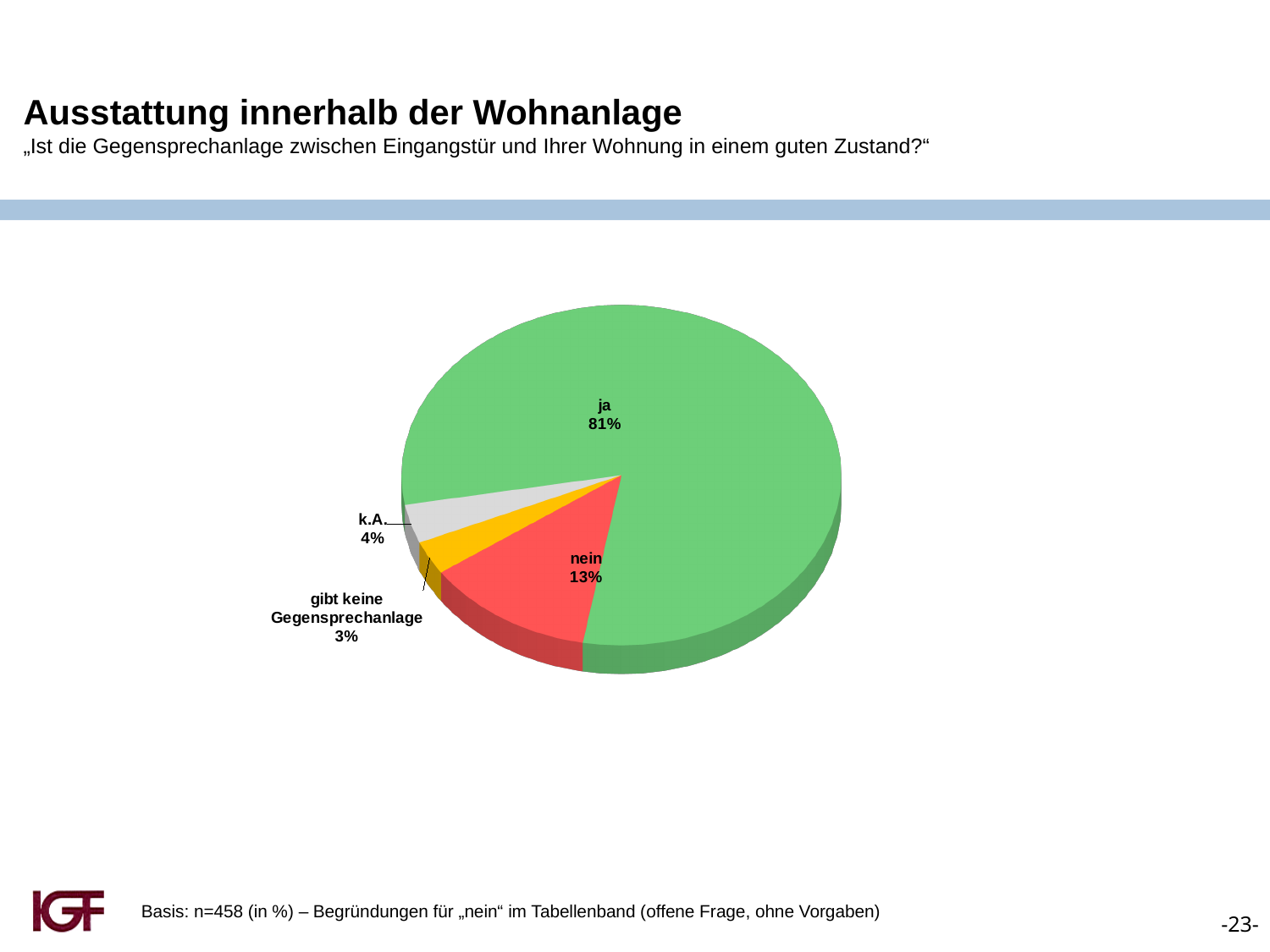
What is the share for "k.A."? 4% Which category has the largest slice of the pie? ja How many slices does the pie chart have? 4 What percentage of respondents answered "ja"? 81% What is the share for "gibt keine Gegensprechanlage"? 3% Which is larger, the share for "nein" or the share for "k.A."? nein What colour is the "nein" slice? red What is the sample size (n) stated below the chart? n=458 What percentage of respondents answered "nein"? 13% What is the difference in percentage points between "ja" and "nein"? 68 Which category has the smallest slice of the pie? gibt keine Gegensprechanlage What kind of chart is shown on the slide? pie chart